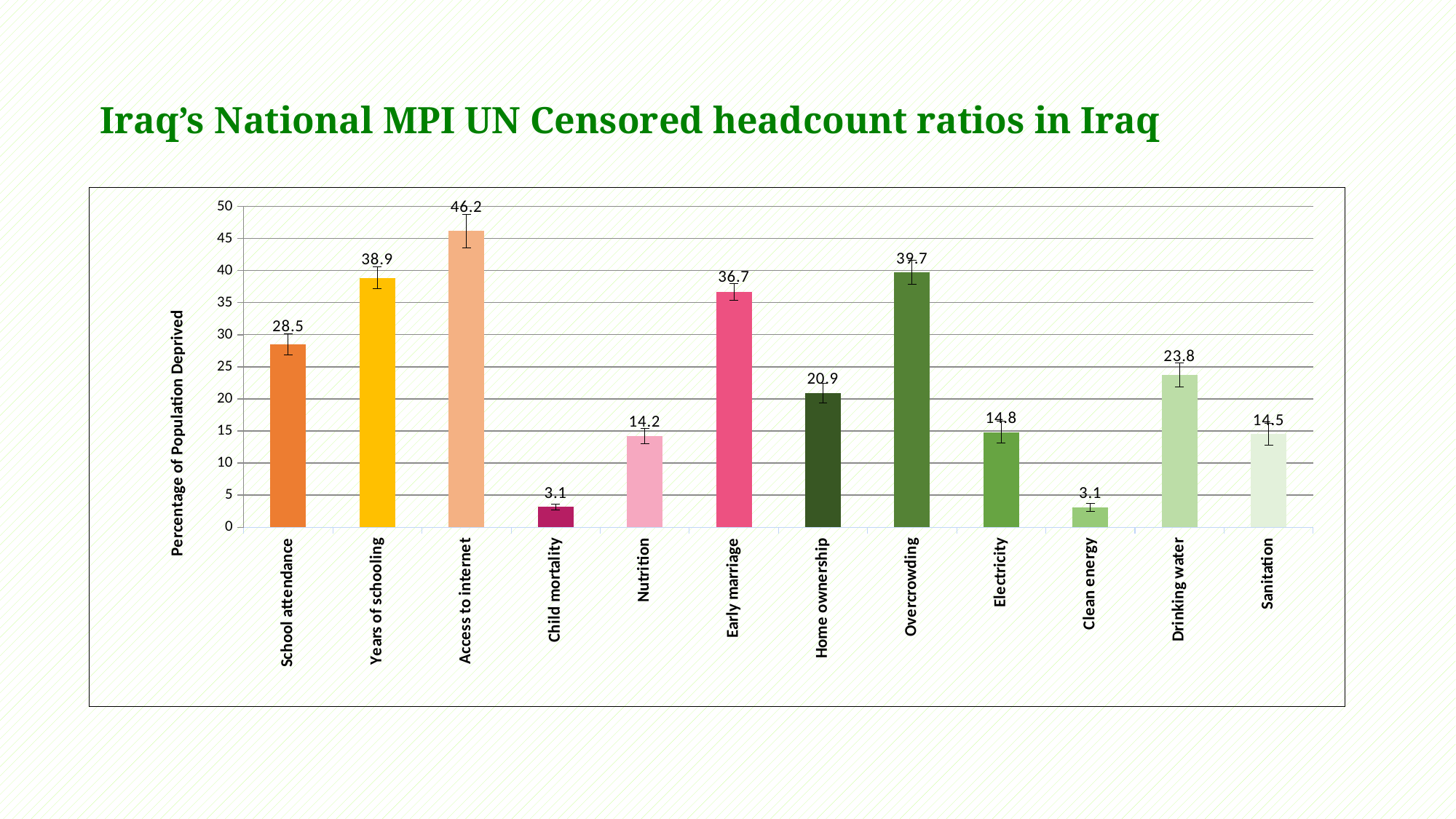
What is the value for Access to internet? 46.2 Which category has the highest value? Access to internet What is the title of the slide? Iraq's National MPI UN Censored headcount ratios in Iraq Is the value for Sanitation greater or less than 20? less What is the difference between the values for Overcrowding and Early marriage? 3 Which is larger, the value for Electricity or the value for Nutrition? Electricity How many categories are shown on the x axis? 12 What kind of chart is shown on the slide? bar chart What is the label of the vertical axis? Percentage of Population Deprived What is the value for Drinking water? 23.8 What is the value for Home ownership? 20.9 What is the difference between the values for Years of schooling and School attendance? 10.4